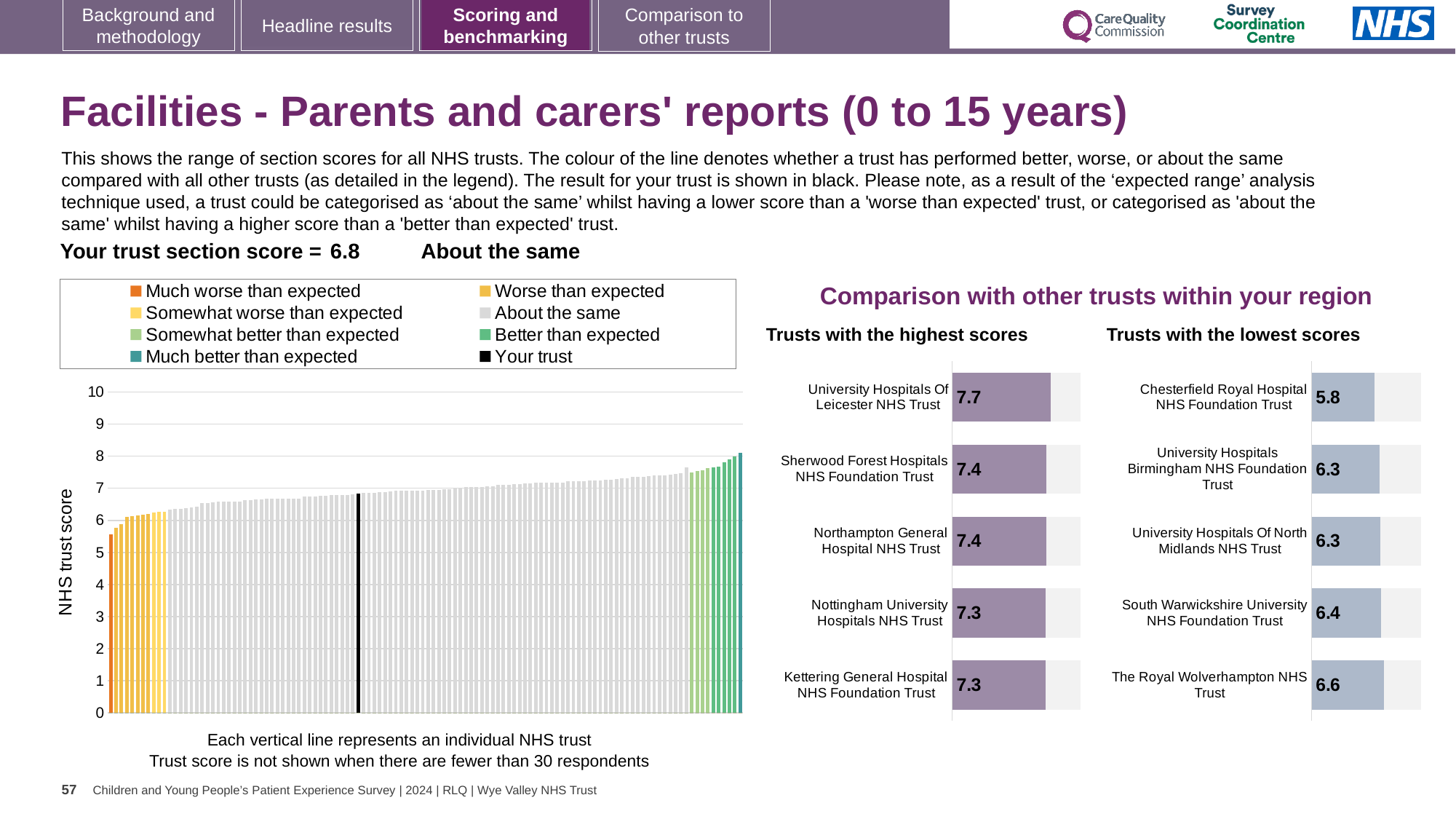
In the 'Trusts with the lowest scores' chart, what is the difference between the scores of The Royal Wolverhampton NHS Trust and Chesterfield Royal Hospital NHS Foundation Trust? 0.8 In the large chart on the left showing all NHS trusts, is the value of the lowest (orange) bar greater or less than 6? less In the 'Trusts with the lowest scores' chart, what is the score for Chesterfield Royal Hospital NHS Foundation Trust? 5.8 In the 'Trusts with the highest scores' chart, what is the difference between the scores of University Hospitals Of Leicester NHS Trust and Kettering General Hospital NHS Foundation Trust? 0.4 In the 'Trusts with the highest scores' chart, which trust has the highest score? University Hospitals Of Leicester NHS Trust In the 'Trusts with the lowest scores' chart, which trust has the lowest score? Chesterfield Royal Hospital NHS Foundation Trust What kind of chart is the large chart on the left with the y axis labelled 'NHS trust score'? bar chart Which is larger: the score for Sherwood Forest Hospitals NHS Foundation Trust in the highest scores chart, or the score for South Warwickshire University NHS Foundation Trust in the lowest scores chart? Sherwood Forest Hospitals NHS Foundation Trust In the 'Trusts with the highest scores' chart, what is the score for University Hospitals Of Leicester NHS Trust? 7.7 In the 'Trusts with the highest scores' chart, what is the score for Kettering General Hospital NHS Foundation Trust? 7.3 In the 'Trusts with the lowest scores' chart, what is the score for The Royal Wolverhampton NHS Trust? 6.6 How many trusts are shown in the 'Trusts with the lowest scores' chart? 5